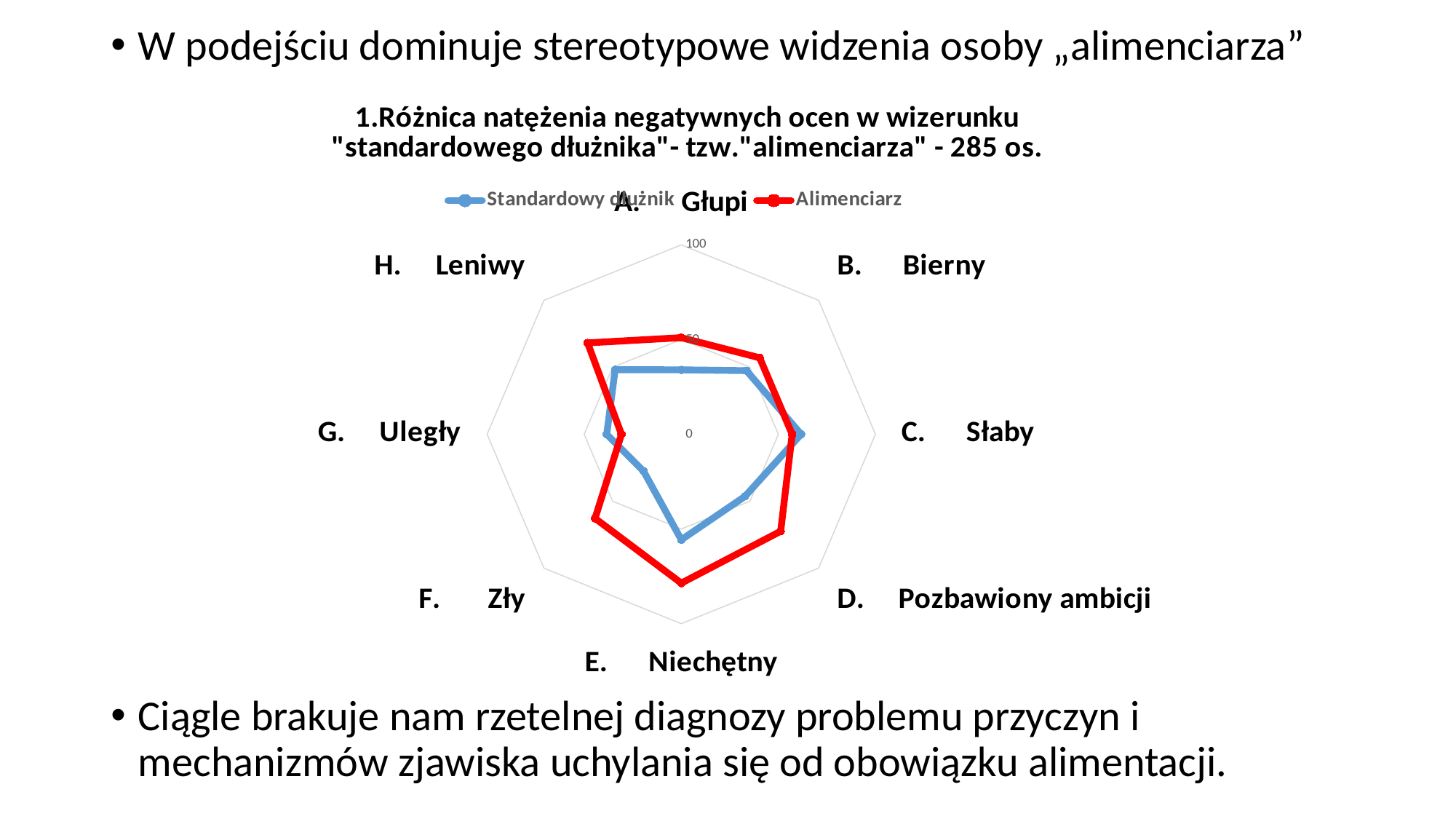
Is the value of Alimenciarz for H. Leniwy greater or less than 50? greater Is the value of Standardowy dłużnik for A. Głupi greater or less than 50? less How many series does the chart legend list? 2 Is the value of Alimenciarz for G. Uległy greater or less than 50? less For which category does the Alimenciarz series have its lowest value? G. Uległy For F. Zły, which series has the larger value, Standardowy dłużnik or Alimenciarz? Alimenciarz What kind of chart is shown on the slide? Radar chart How many categories (axes) does the radar chart have? 8 Which series is drawn in blue on the chart? Standardowy dłużnik Which series is drawn in red on the chart? Alimenciarz